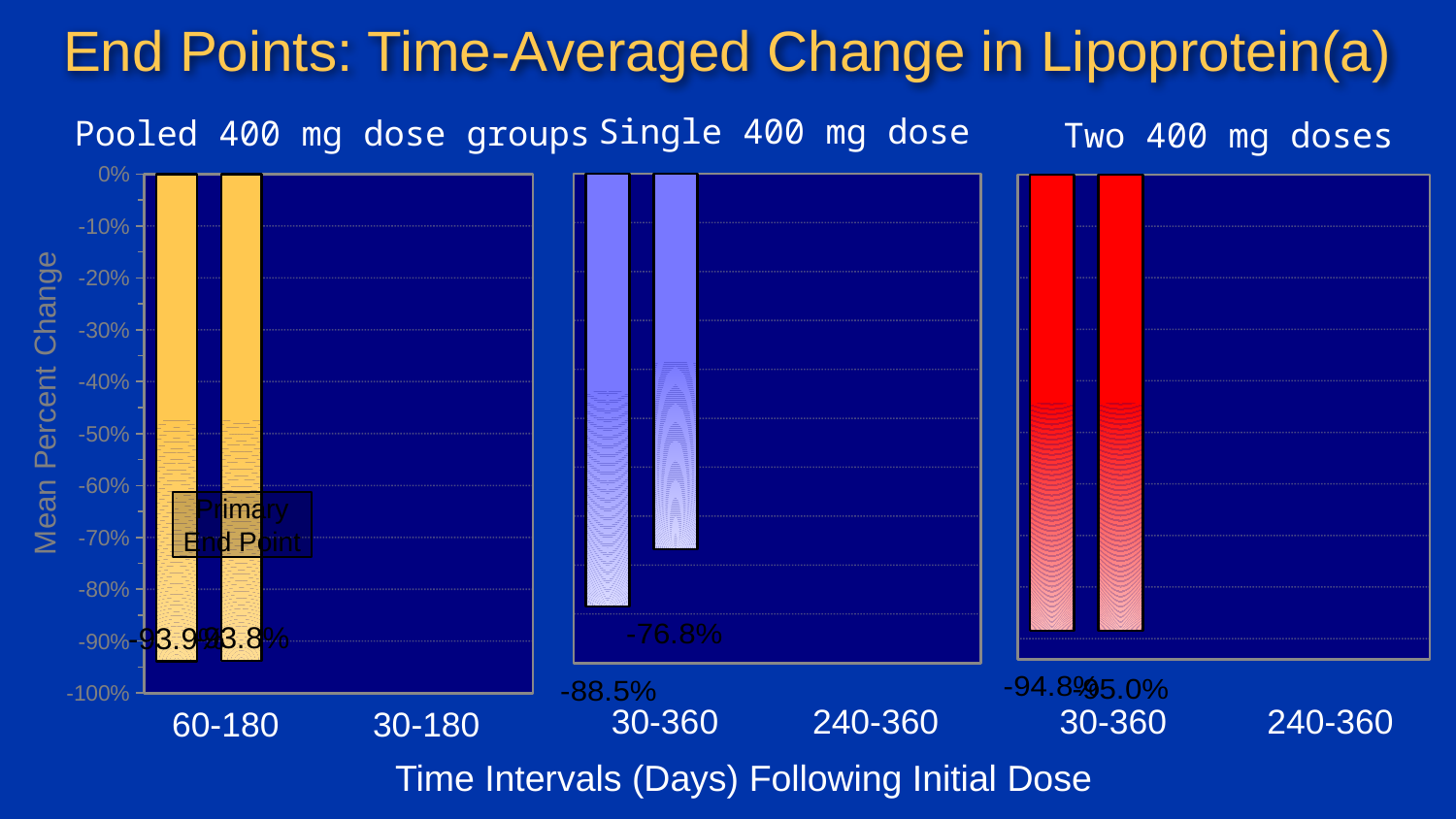
How many bars are plotted in the Two 400 mg doses chart? 2 What kind of chart is used on this slide? bar chart In the Single 400 mg dose chart, is the value of the right bar greater or less than -50%? less What colour are the bars in the Two 400 mg doses chart? red How many charts are shown on the slide? 3 In the Two 400 mg doses chart, what is the value of the left bar? -94.8% In the Pooled 400 mg dose groups chart, what is the value of the left bar? -93.9% In the Single 400 mg dose chart, what is the value of the left bar? -88.5% In the Single 400 mg dose chart, which bar shows the larger percent reduction, the left or the right? left In the Single 400 mg dose chart, what is the value of the right bar? -76.8% In the Single 400 mg dose chart, what is the difference between the left bar (-88.5%) and the right bar (-76.8%)? 11.7 percentage points What is the y-axis title shared by the charts? Mean Percent Change